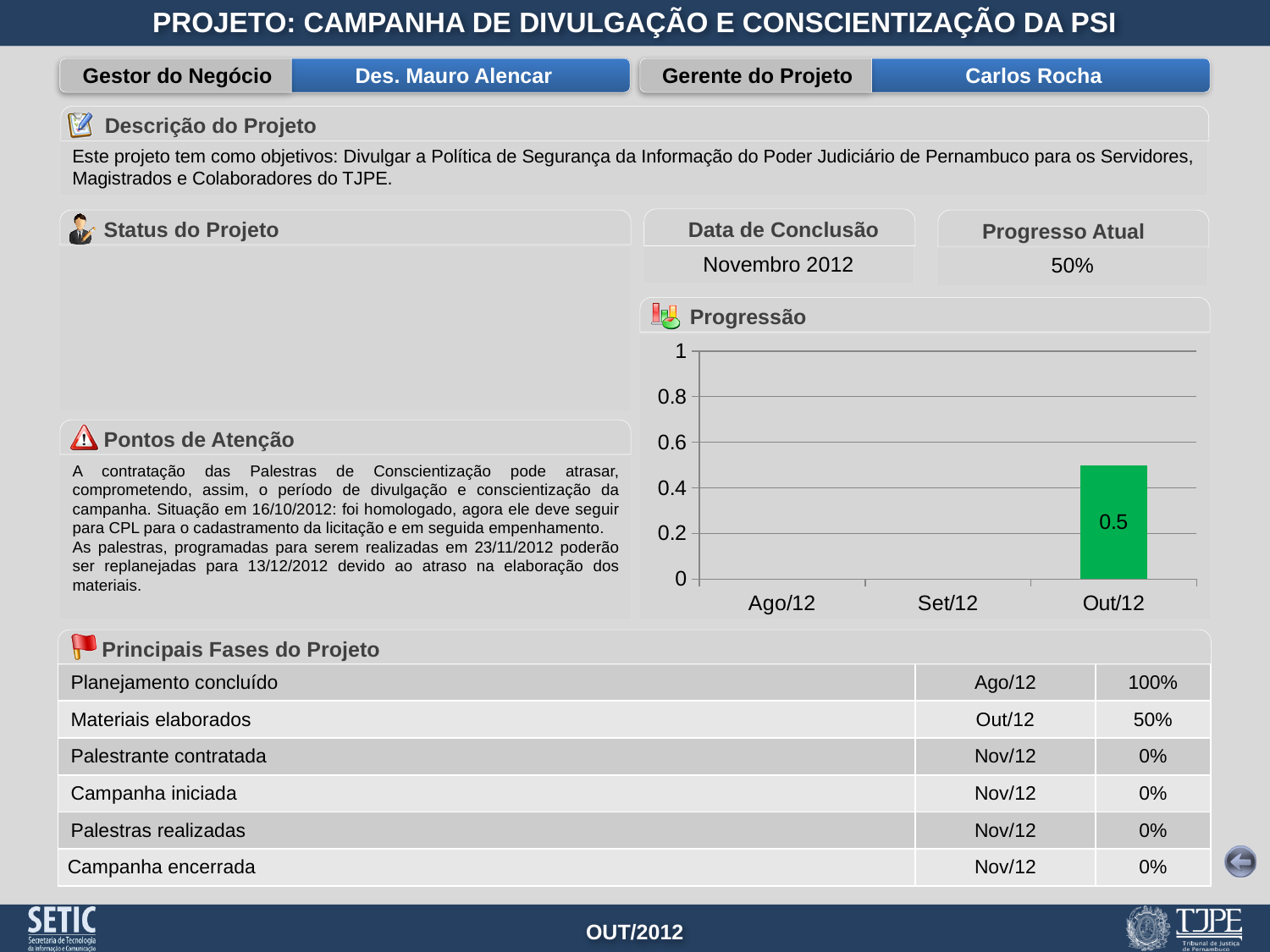
In the Progressão chart, is the value for Out/12 greater or less than 0.4? greater What is the title of the chart on the slide? Progressão How many categories are shown on the x axis of the Progressão chart? 3 In the Progressão chart, which category is listed first on the x axis? Ago/12 Which category has the highest value in the Progressão chart? Out/12 What kind of chart is the Progressão chart? bar chart In the Progressão chart, is the value for Out/12 greater or less than 0.6? less In the Progressão chart, what is the value for Out/12? 0.5 What is the maximum value shown on the y axis of the Progressão chart? 1 In the Progressão chart, which is larger, the value for Out/12 or the value for Set/12? Out/12